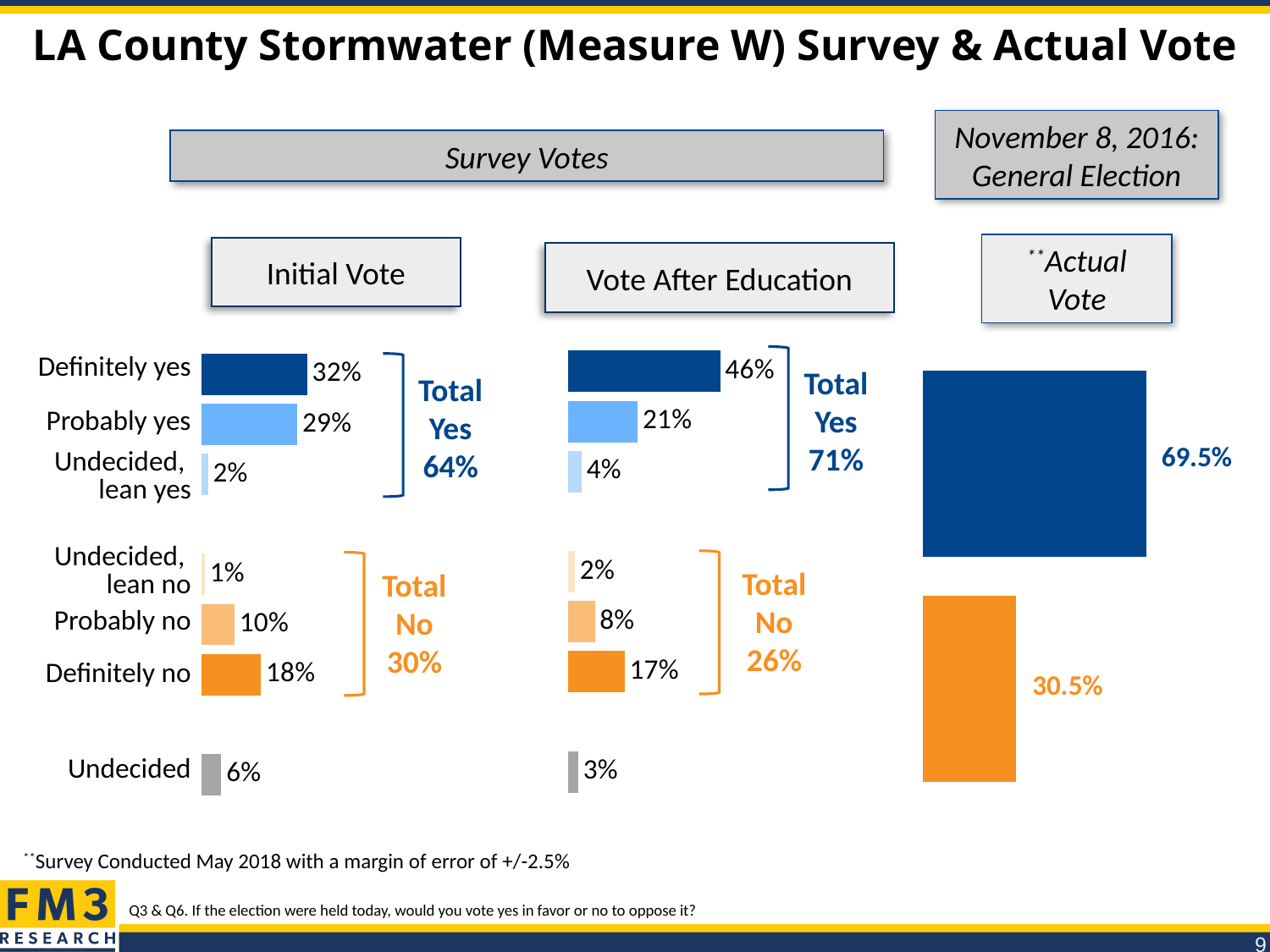
How many categories are shown in the Initial Vote chart? 7 What is the difference between the "Definitely yes" percentage in the Vote After Education chart and in the Initial Vote chart? 14% In the Vote After Education chart, what percentage were "Undecided"? 3% In the Initial Vote chart, which is larger: "Probably yes" or "Definitely no"? Probably yes In the Vote After Education chart, what percentage said "Definitely yes"? 46% What kind of chart is used for the Initial Vote data? Bar chart In the Vote After Education chart, which category has the lowest percentage? Undecided, lean no In the Initial Vote chart, which category has the highest percentage? Definitely yes What is the Total No percentage shown for the Vote After Education chart? 26% In the Initial Vote chart, what percentage said "Probably no"? 10% In the Initial Vote chart, what percentage said "Definitely yes"? 32% In the Actual Vote chart, what percentage voted yes? 69.5%